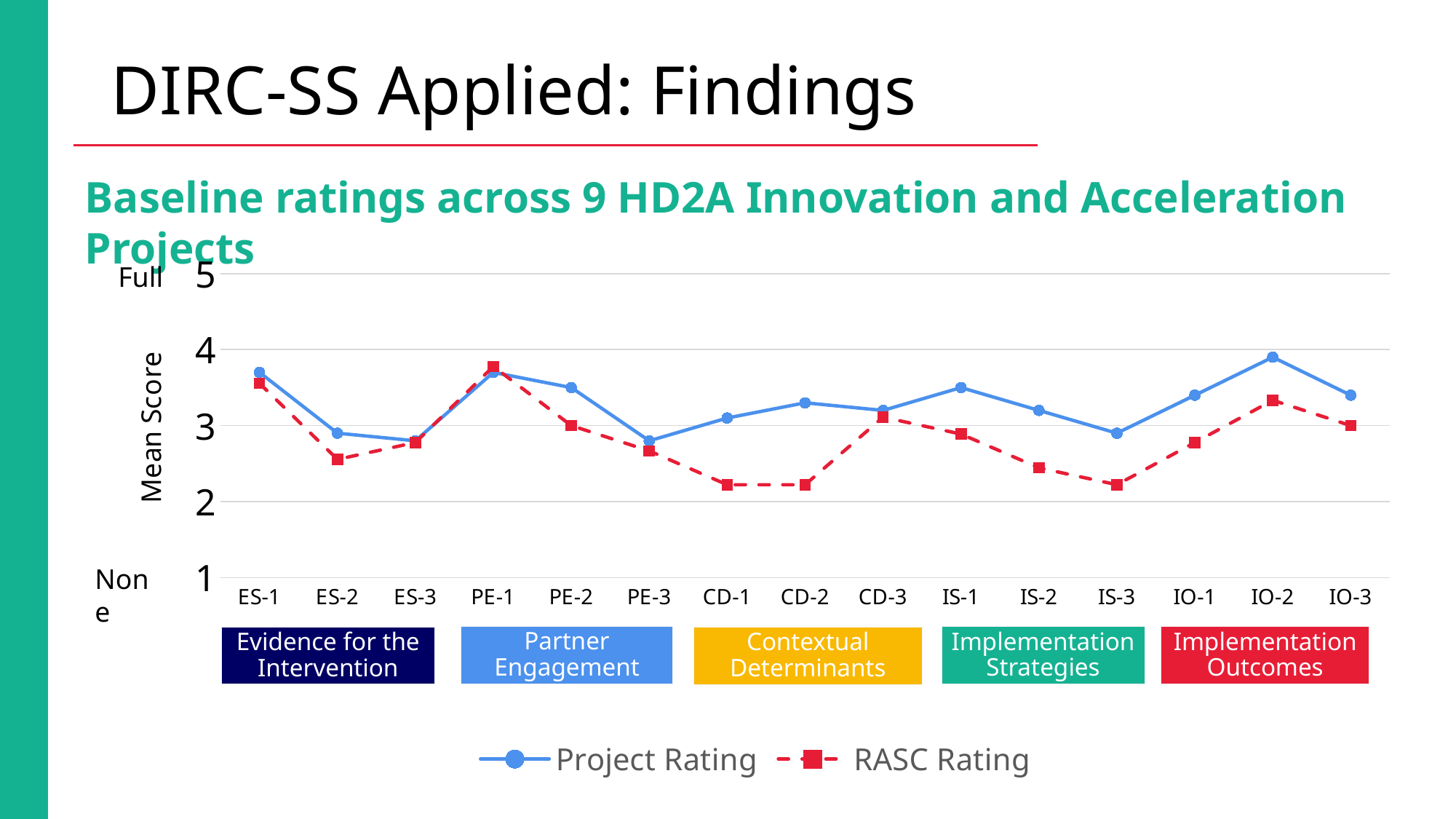
What kind of chart is shown on the slide? line chart What is the label on the y axis of the chart? Mean Score Which category has the highest RASC Rating? PE-1 Does the Project Rating rise or fall from IO-2 to IO-3? fall Is the Project Rating for IO-2 greater or less than 3? greater How many project categories are plotted along the x axis? 15 Is the RASC Rating for CD-1 greater or less than 3? less Is the Project Rating for PE-2 greater or less than 3? greater For IS-2, which is larger: the Project Rating or the RASC Rating? Project Rating Which category has the highest Project Rating? IO-2 How many series does the legend list? 2